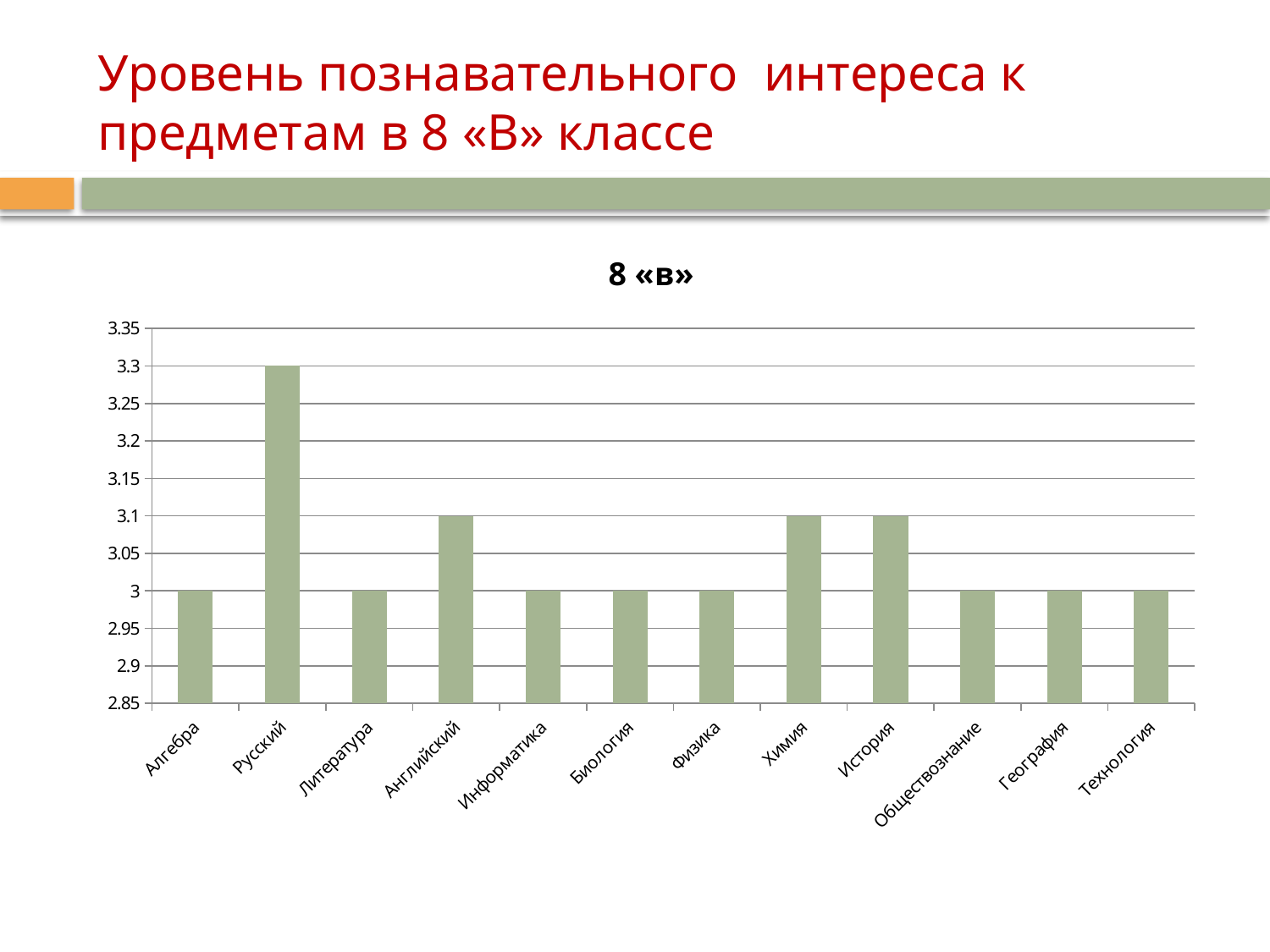
What kind of chart is shown on the slide? bar chart What is the title of the chart? 8 «в» What is the value for Русский? 3.3 How many subjects (categories) are shown on the x axis of the chart? 12 What is the value for Английский? 3.1 What is the difference between the values for Русский and Химия? 0.2 Which is larger, the value for Химия or the value for Физика? Химия What is the value for Алгебра? 3 Which subject has the highest value in the chart? Русский Is the value for Технология greater or less than 3.05? less What is the value for История? 3.1 Is the value for Русский greater or less than 3.2? greater